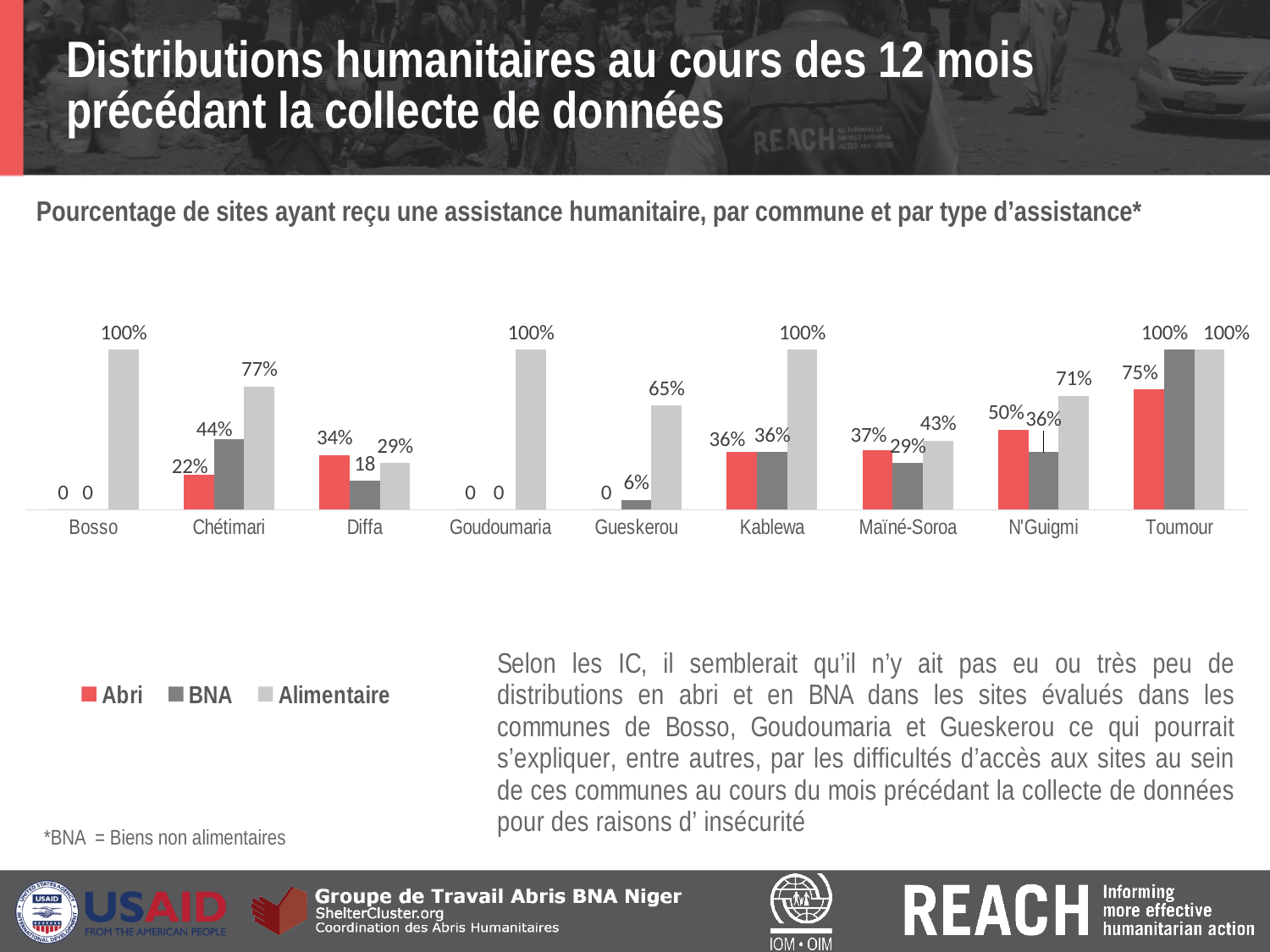
Which commune has the lowest Alimentaire value? Diffa How many communes are shown on the x axis? 9 Which colour represents the BNA series in the legend? Dark grey What kind of chart is shown on the slide? Bar chart How many series does the legend list? 3 What is the Abri value for N'Guigmi? 50% What is the BNA value for Gueskerou? 6% What is the difference between the Alimentaire and Abri values for Chétimari? 55% Which is larger for Diffa: the Abri value or the Alimentaire value? Abri What percentage of sites in Chétimari received Alimentaire assistance? 77% Which commune has the highest Abri value? Toumour What is the Alimentaire value for Maïné-Soroa? 43%